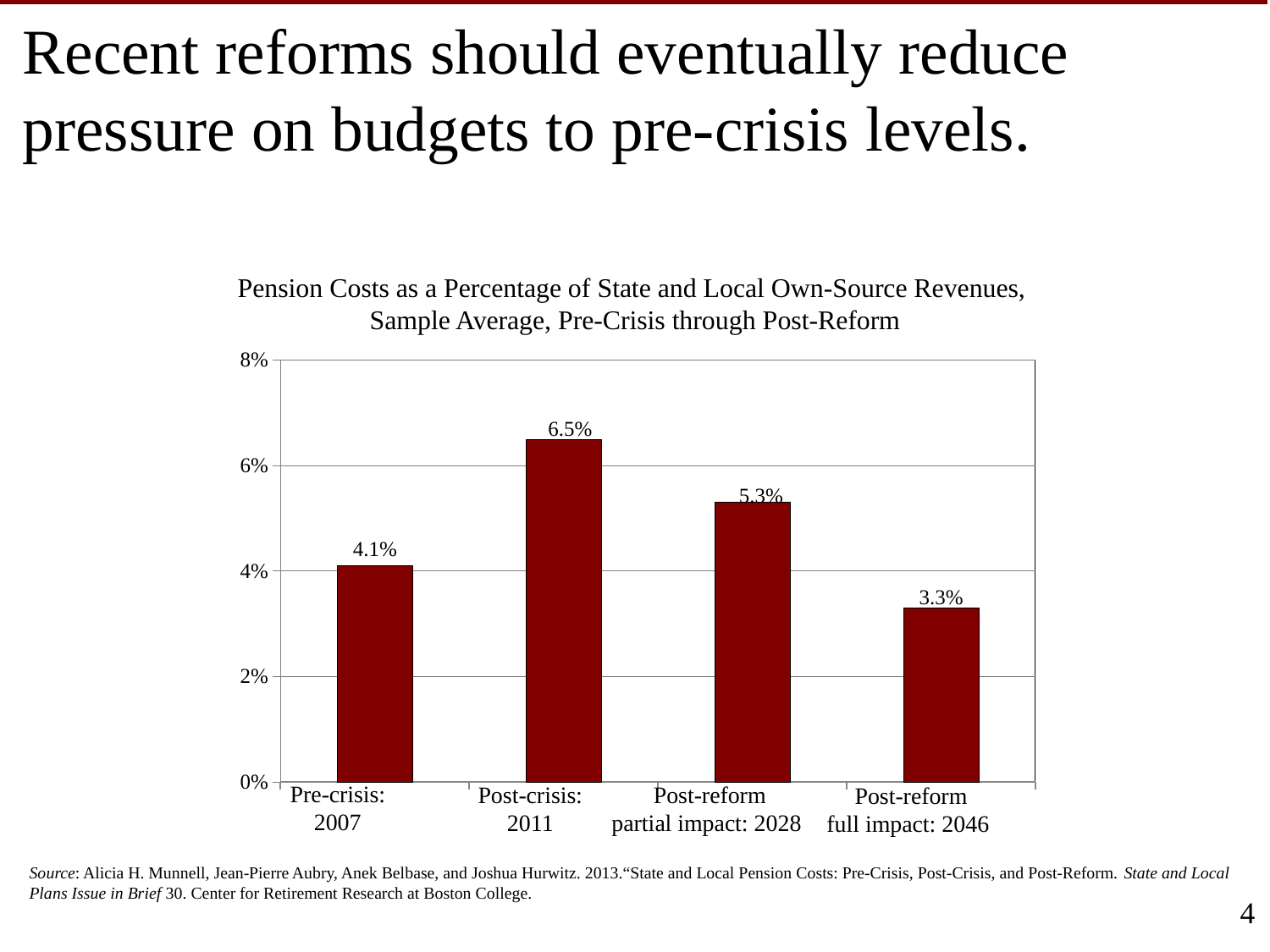
What is the value shown for Post-reform partial impact: 2028? 5.3% What is the difference between the Post-crisis: 2011 value and the Pre-crisis: 2007 value? 2.4% Which is larger, the value for Post-reform partial impact: 2028 or Pre-crisis: 2007? Post-reform partial impact: 2028 Is the value for Post-crisis: 2011 greater or less than 6%? greater What is the value shown for Post-crisis: 2011? 6.5% What is the value shown for Post-reform full impact: 2046? 3.3% How many categories are shown on the x axis? 4 Which category has the highest value? Post-crisis: 2011 What is the title of the chart? Pension Costs as a Percentage of State and Local Own-Source Revenues, Sample Average, Pre-Crisis through Post-Reform What is the pension cost as a percentage of own-source revenues for Pre-crisis: 2007? 4.1% What kind of chart is shown on the slide? Bar chart Which category has the lowest value? Post-reform full impact: 2046